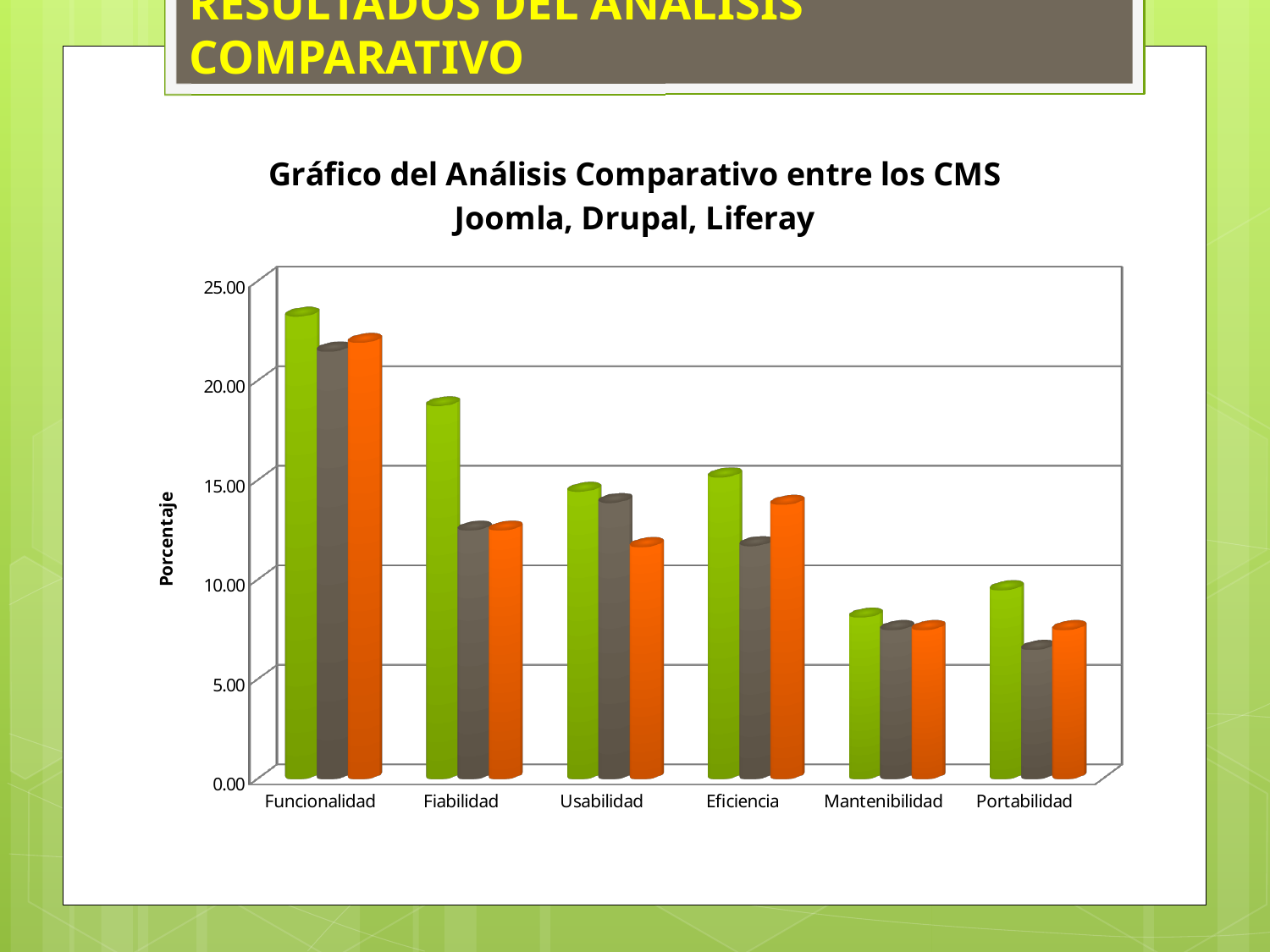
What is the label of the vertical axis of the chart? Porcentaje What kind of chart is shown on the slide? bar chart How many bars are plotted for each category in the chart? 3 What is the title of the chart? Gráfico del Análisis Comparativo entre los CMS Joomla, Drupal, Liferay For which category is the green bar the lowest? Mantenibilidad Is the value of the green bar for Funcionalidad greater or less than 20.00? greater Is the value of the green bar for Mantenibilidad greater or less than 10.00? less For which category is the green bar the highest? Funcionalidad Is the value of the orange bar for Eficiencia greater or less than 10.00? greater How many categories are shown on the x axis of the chart? 6 For Fiabilidad, which is larger: the green bar or the gray bar? the green bar